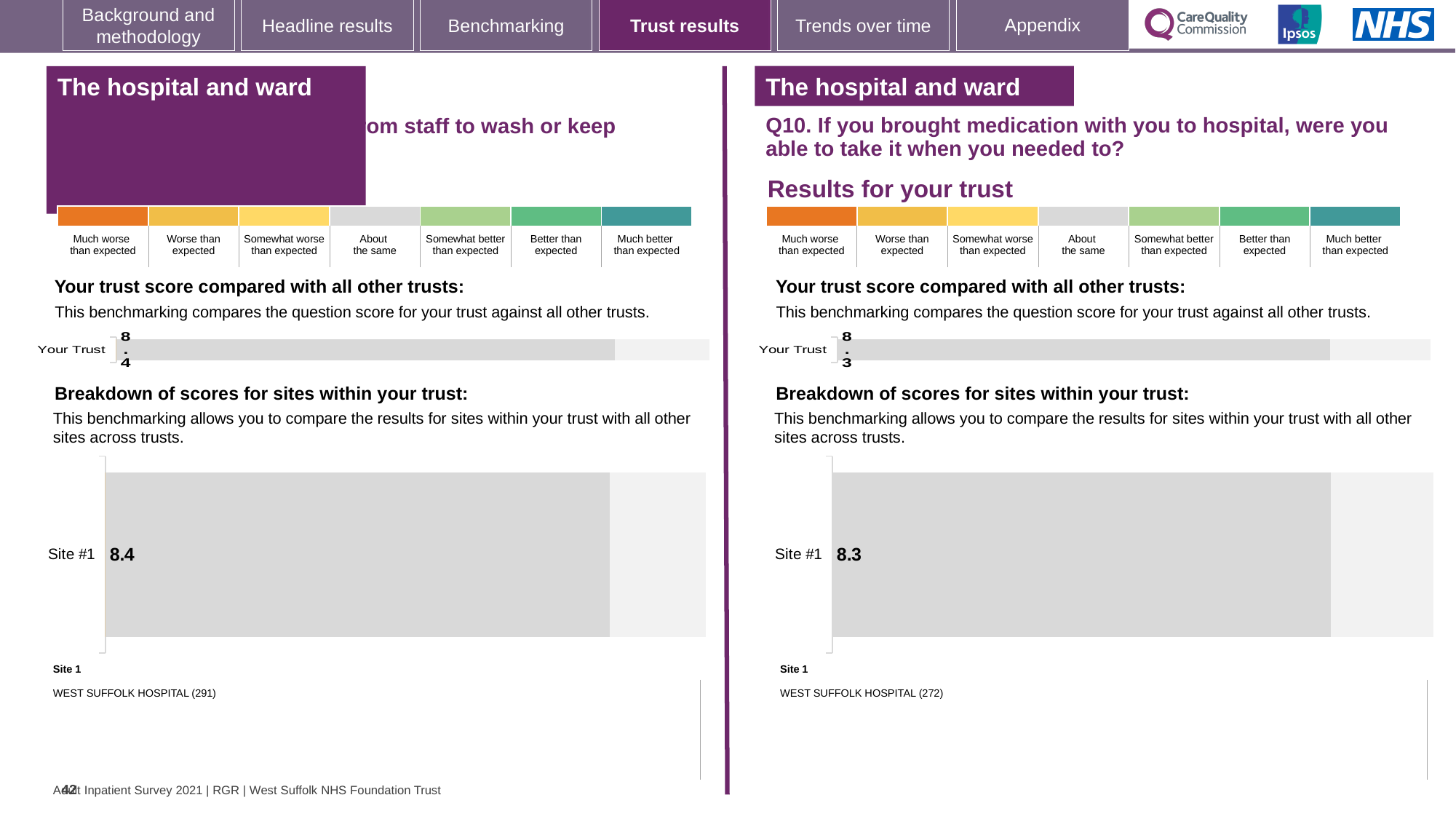
What type of chart is used to show the Site #1 score on the left-hand panel? Bar chart On the left-hand panel, what is the score shown for Your Trust in the trust score comparison chart? 8.4 Which is larger: the Your Trust score on the left-hand panel or the Your Trust score on the right-hand panel (Q10)? Left-hand panel (8.4) On the left-hand panel, which site is listed as Site 1 below the breakdown chart? WEST SUFFOLK HOSPITAL (291) On the right-hand panel (Q10, about taking medication brought to hospital), what is the score shown for Your Trust? 8.3 On the right-hand panel (Q10), is the Your Trust score of 8.3 greater or less than the Site #1 score of 8.3, or are they equal? Equal How many sites are shown in the breakdown of scores chart on the right-hand panel (Q10)? 1 On the right-hand panel (Q10), what score is shown for Site #1 in the breakdown of scores for sites within your trust? 8.3 On the right-hand panel (Q10), which site is listed as Site 1 below the breakdown chart? WEST SUFFOLK HOSPITAL (272) What is the difference between the Site #1 score on the left-hand panel (8.4) and the Site #1 score on the right-hand panel (8.3)? 0.1 On the left-hand panel, what score is shown for Site #1 in the breakdown of scores for sites within your trust? 8.4